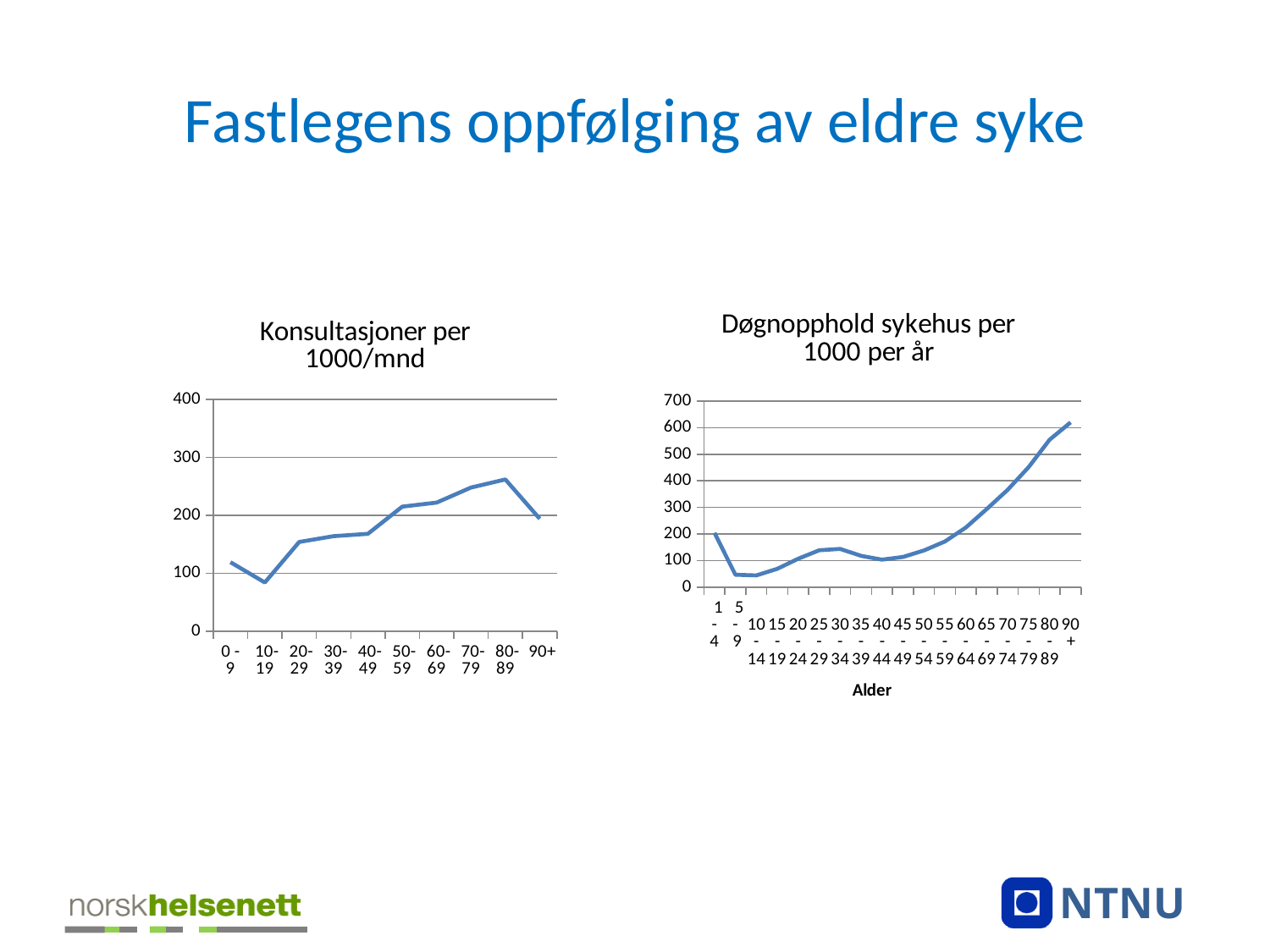
In the 'Døgnopphold sykehus per 1000 per år' chart, is the value for 90+ greater or less than 500? greater In the 'Konsultasjoner per 1000/mnd' chart, how many age categories are shown on the x axis? 10 What kind of chart is the 'Døgnopphold sykehus per 1000 per år' chart? line chart What is the x-axis title of the 'Døgnopphold sykehus per 1000 per år' chart? Alder In the 'Døgnopphold sykehus per 1000 per år' chart, which age group has the highest value? 90+ In the 'Konsultasjoner per 1000/mnd' chart, is the value for 80-89 greater or less than 200? greater In the 'Døgnopphold sykehus per 1000 per år' chart, is the value for 40-44 greater or less than 200? less In the 'Døgnopphold sykehus per 1000 per år' chart, how many age categories are shown on the x axis? 18 What kind of chart is the 'Konsultasjoner per 1000/mnd' chart? line chart In the 'Konsultasjoner per 1000/mnd' chart, which age group has the lowest value? 10-19 In the 'Konsultasjoner per 1000/mnd' chart, which age group has the highest value? 80-89